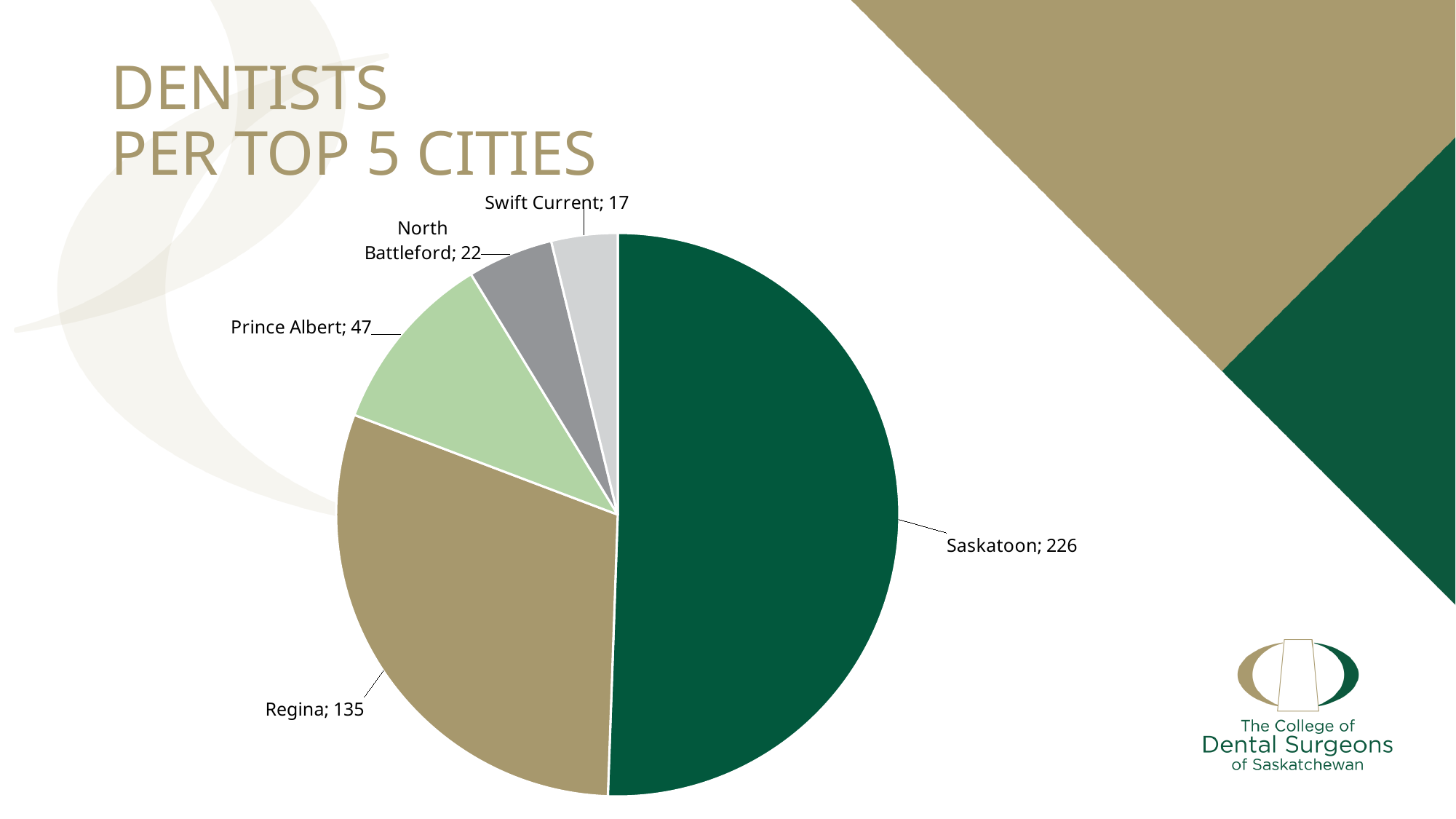
What is the title of the slide containing the pie chart? Dentists per Top 5 Cities How many dentists does the pie chart show for Saskatoon? 226 Which has more dentists, Prince Albert or North Battleford? Prince Albert How many dentists are shown for North Battleford? 22 How many cities are shown in the pie chart? 5 What kind of chart is shown on the slide? Pie chart What is the total number of dentists across all five cities in the pie chart? 447 Which city has the largest slice of the pie chart? Saskatoon What is the value shown for Regina in the pie chart? 135 How many more dentists does Prince Albert have than Swift Current? 30 What is the difference between the number of dentists in Saskatoon and in Regina? 91 Which city has the smallest slice of the pie chart? Swift Current